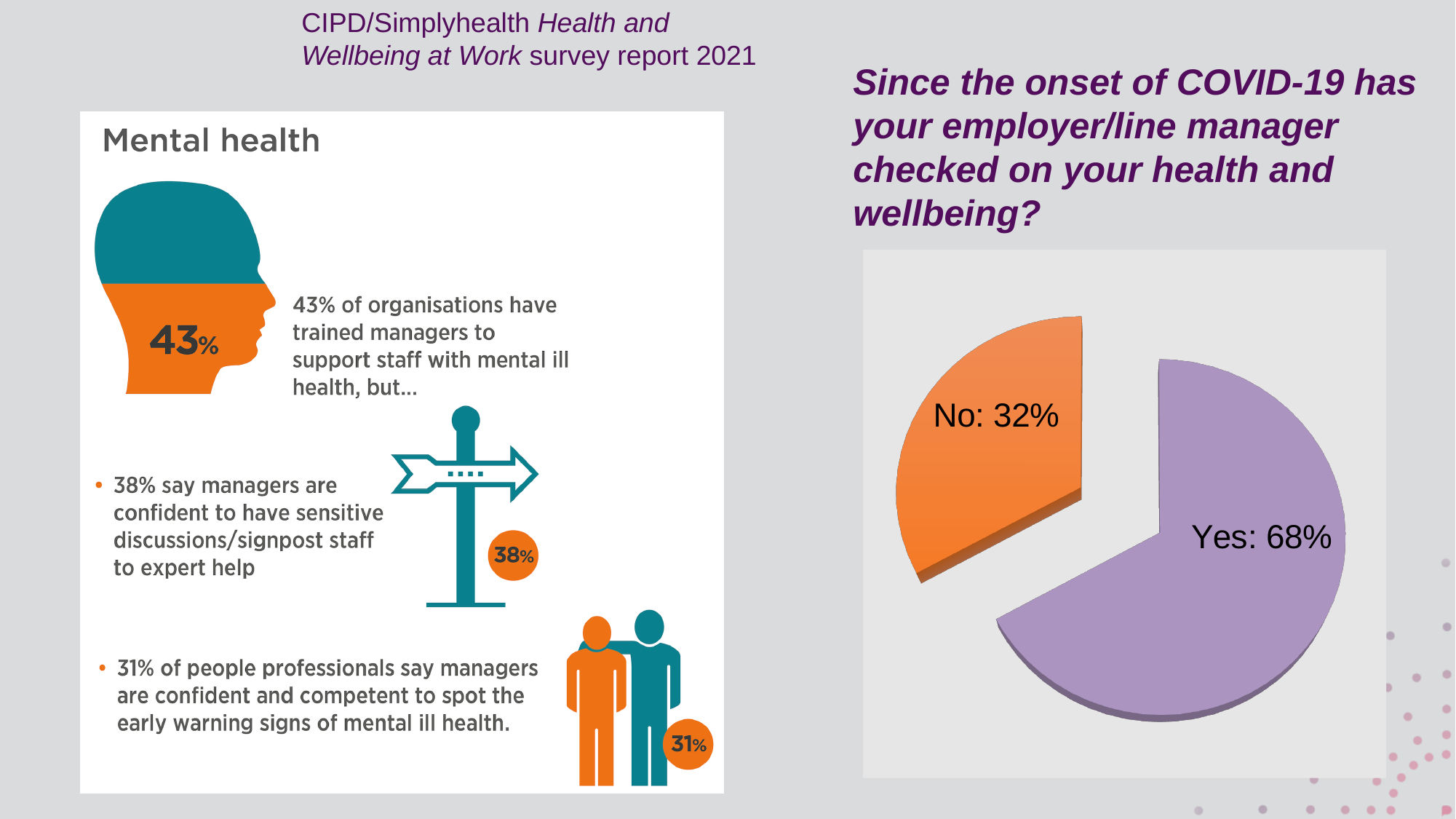
What question does the pie chart's title ask? Since the onset of COVID-19 has your employer/line manager checked on your health and wellbeing? What kind of chart is shown on the right of the slide? pie chart What colour is the Yes slice in the pie chart? purple In the pie chart, what percentage of respondents answered No? 32% How many slices does the pie chart have? 2 In the pie chart, what is the difference in percentage points between the Yes and No slices? 36 Which slice of the pie chart is the smallest? No In the pie chart, what percentage of respondents answered Yes? 68% In the pie chart, is the value for Yes greater or less than 50%? greater Which slice of the pie chart is the largest? Yes In the pie chart, is the Yes slice larger or smaller than the No slice? larger What share of the pie does the No slice represent? 32%